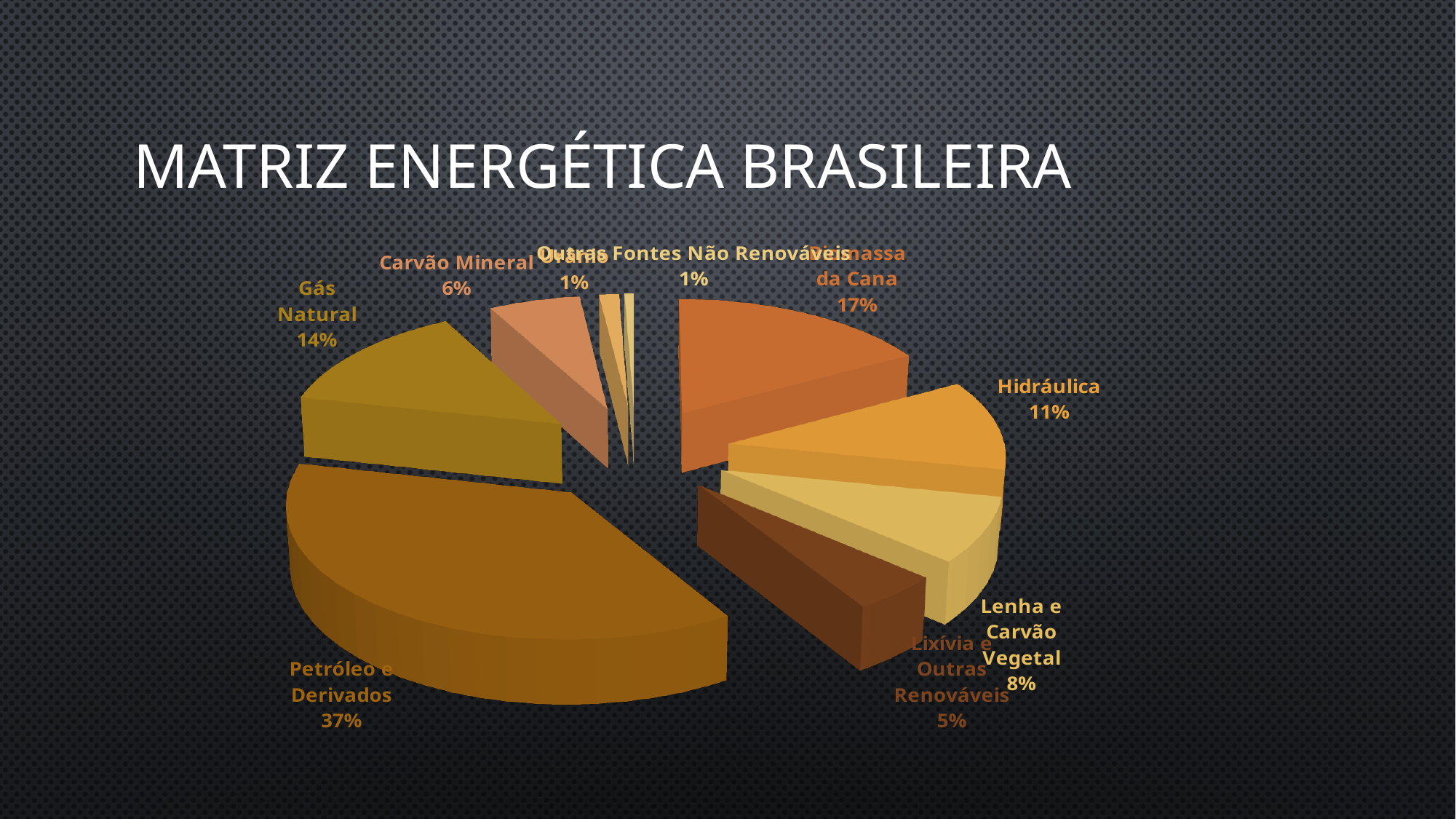
What is the title of the slide? Matriz Energética Brasileira What kind of chart is shown on the slide? Pie chart Which is larger, Hidráulica or Lenha e Carvão Vegetal? Hidráulica Which category has the largest slice of the pie? Petróleo e Derivados What is the value shown for Lixívia e Outras Renováveis? 5% What is the value shown for Hidráulica? 11% What is the value shown for Gás Natural? 14% What is the value shown for Lenha e Carvão Vegetal? 8% What share of the pie does Petróleo e Derivados have? 37% How many slices does the pie chart have? 9 What is the value shown for Carvão Mineral? 6% What is the difference in percentage points between Petróleo e Derivados and Gás Natural? 23 percentage points